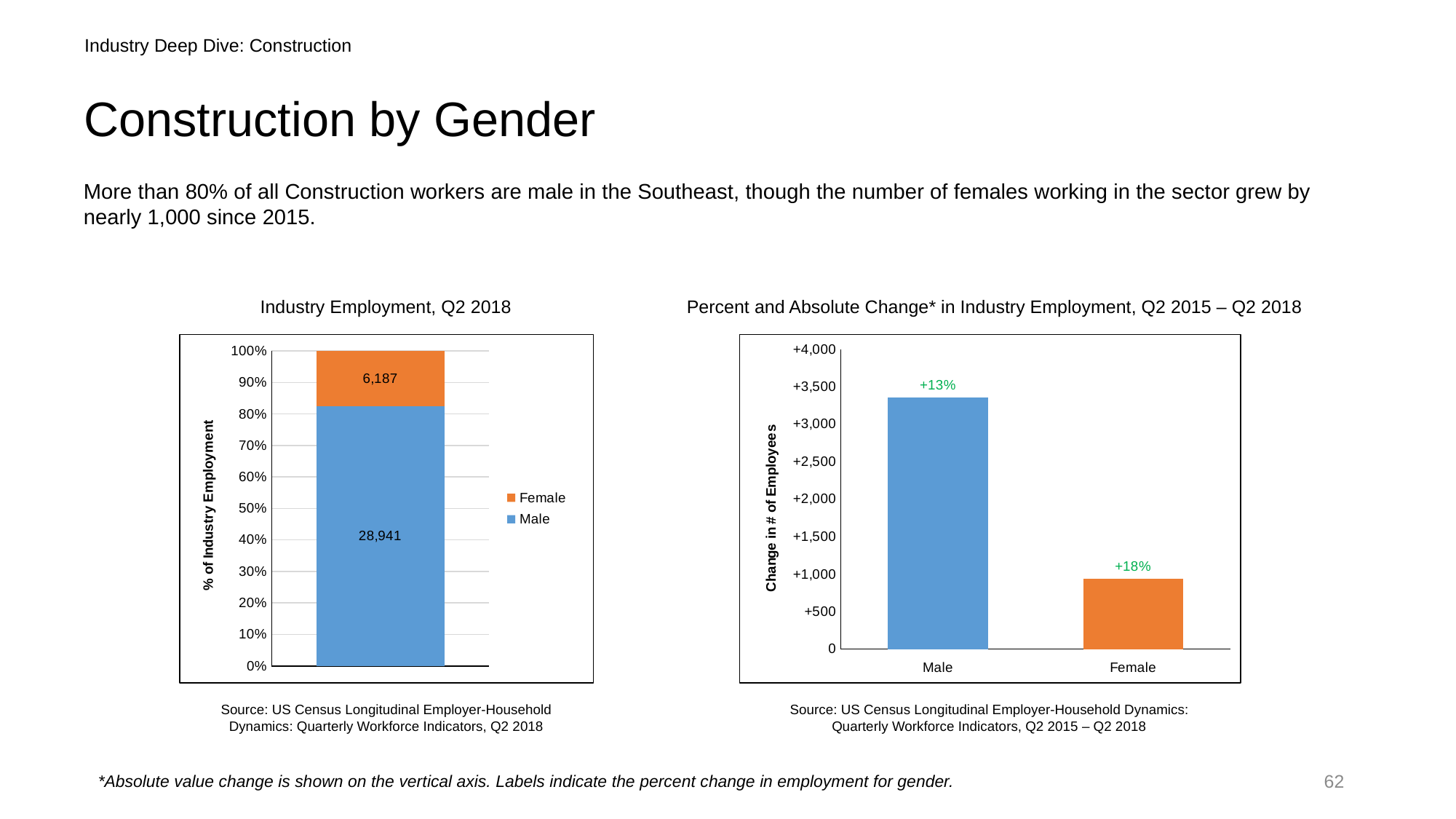
What kind of chart is the 'Industry Employment, Q2 2018' chart? Stacked bar chart In the 'Industry Employment, Q2 2018' chart, what is the total of the male and female values in the stacked bar? 35,128 In the 'Percent and Absolute Change in Industry Employment' chart, is the absolute change for Male greater or less than +3,000? greater In the 'Percent and Absolute Change in Industry Employment' chart, which gender has the larger absolute change in number of employees? Male In the 'Percent and Absolute Change in Industry Employment' chart, what is the vertical axis title? Change in # of Employees In the 'Percent and Absolute Change in Industry Employment' chart, is the absolute change for Female greater or less than +1,000? less In the 'Percent and Absolute Change in Industry Employment' chart, what is the percent change labelled for Male? +13% In the 'Industry Employment, Q2 2018' chart, how many female employees are shown? 6,187 In the 'Percent and Absolute Change in Industry Employment' chart, which gender has the higher percent change? Female In the 'Industry Employment, Q2 2018' chart, how many series does the legend list? 2 In the 'Industry Employment, Q2 2018' chart, how many male employees are shown? 28,941 In the 'Percent and Absolute Change in Industry Employment' chart, what is the percent change labelled for Female? +18%